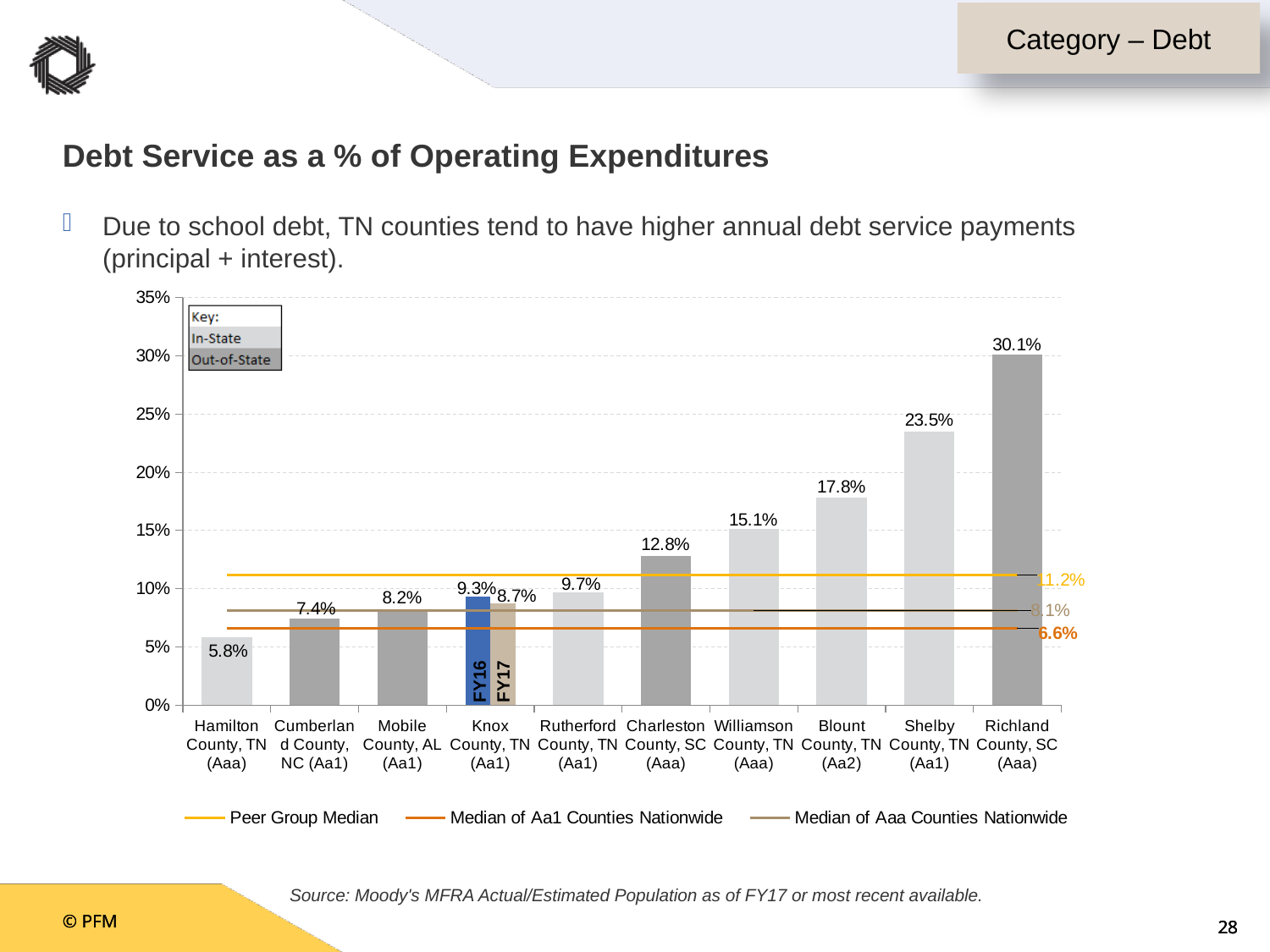
Which is larger, the value for Blount County, TN or the value for Williamson County, TN? Blount County, TN How many counties are shown on the x axis of the chart? 10 What kind of chart is shown on the slide? Bar chart What is the FY16 value shown for Knox County, TN (Aa1)? 9.3% What is the Peer Group Median value shown on the chart? 11.2% Which county has the lowest debt service as a % of operating expenditures? Hamilton County, TN (Aaa) What is the debt service as a % of operating expenditures for Richland County, SC (Aaa)? 30.1% What is the value shown for Shelby County, TN (Aa1)? 23.5% What is the difference between the values for Richland County, SC and Shelby County, TN? 6.6% What is the FY17 value shown for Knox County, TN (Aa1)? 8.7% How many median lines does the legend below the chart list? 3 Which county has the highest debt service as a % of operating expenditures? Richland County, SC (Aaa)